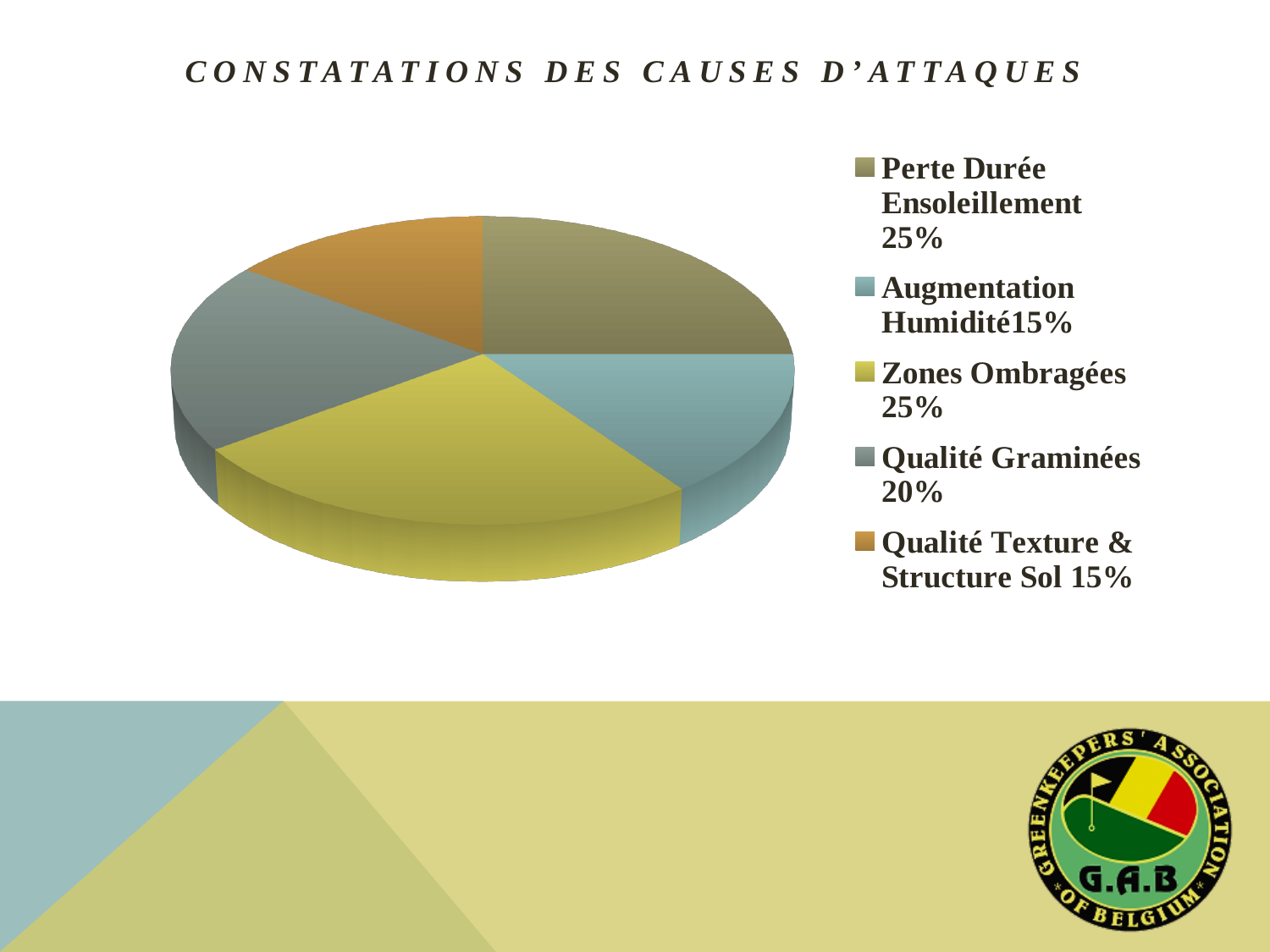
What is the difference in percentage points between the share for Zones Ombragées and the share for Qualité Graminées? 5 What share of the pie does Perte Durée Ensoleillement represent? 25% What is the title of the slide containing the pie chart? CONSTATATIONS DES CAUSES D'ATTAQUES What share of the pie does Zones Ombragées represent? 25% How many categories does the pie chart have? 5 Which is larger: the share for Qualité Graminées or the share for Augmentation Humidité? Qualité Graminées Which is larger: the share for Zones Ombragées or the share for Qualité Texture & Structure Sol? Zones Ombragées What share of the pie does Qualité Texture & Structure Sol represent? 15% What is the difference in percentage points between the share for Perte Durée Ensoleillement and the share for Augmentation Humidité? 10 What kind of chart is shown on the slide? pie chart